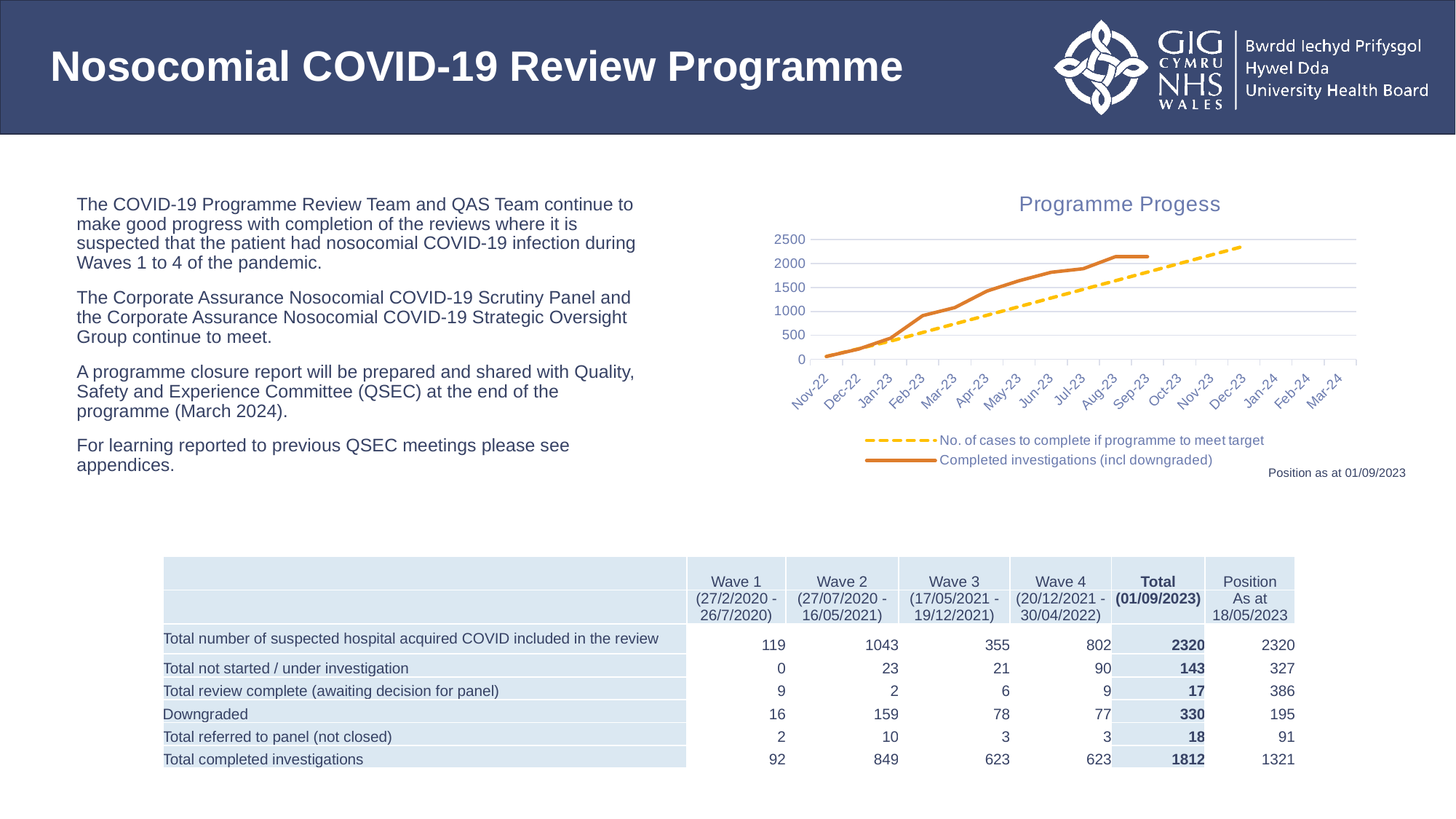
In the 'Programme Progess' chart, is the value of 'Completed investigations (incl downgraded)' at Jun-23 greater or less than 1500? greater What is the title of the line chart on the slide? Programme Progess In the 'Programme Progess' chart, is the value of 'No. of cases to complete if programme to meet target' at Dec-23 greater or less than 2000? greater What kind of chart is the 'Programme Progess' chart? line chart In the 'Programme Progess' chart, is the value of 'Completed investigations (incl downgraded)' at Feb-23 greater or less than 1000? less In the 'Programme Progess' chart, does the 'Completed investigations (incl downgraded)' line rise or fall from Nov-22 to Sep-23? rise How many month labels are shown on the x axis of the 'Programme Progess' chart? 17 How many series does the legend of the 'Programme Progess' chart list? 2 In the 'Programme Progess' chart, at Jun-23 which series has the higher value: 'Completed investigations (incl downgraded)' or 'No. of cases to complete if programme to meet target'? Completed investigations (incl downgraded) In the 'Programme Progess' chart, which series is drawn as a dashed line? No. of cases to complete if programme to meet target